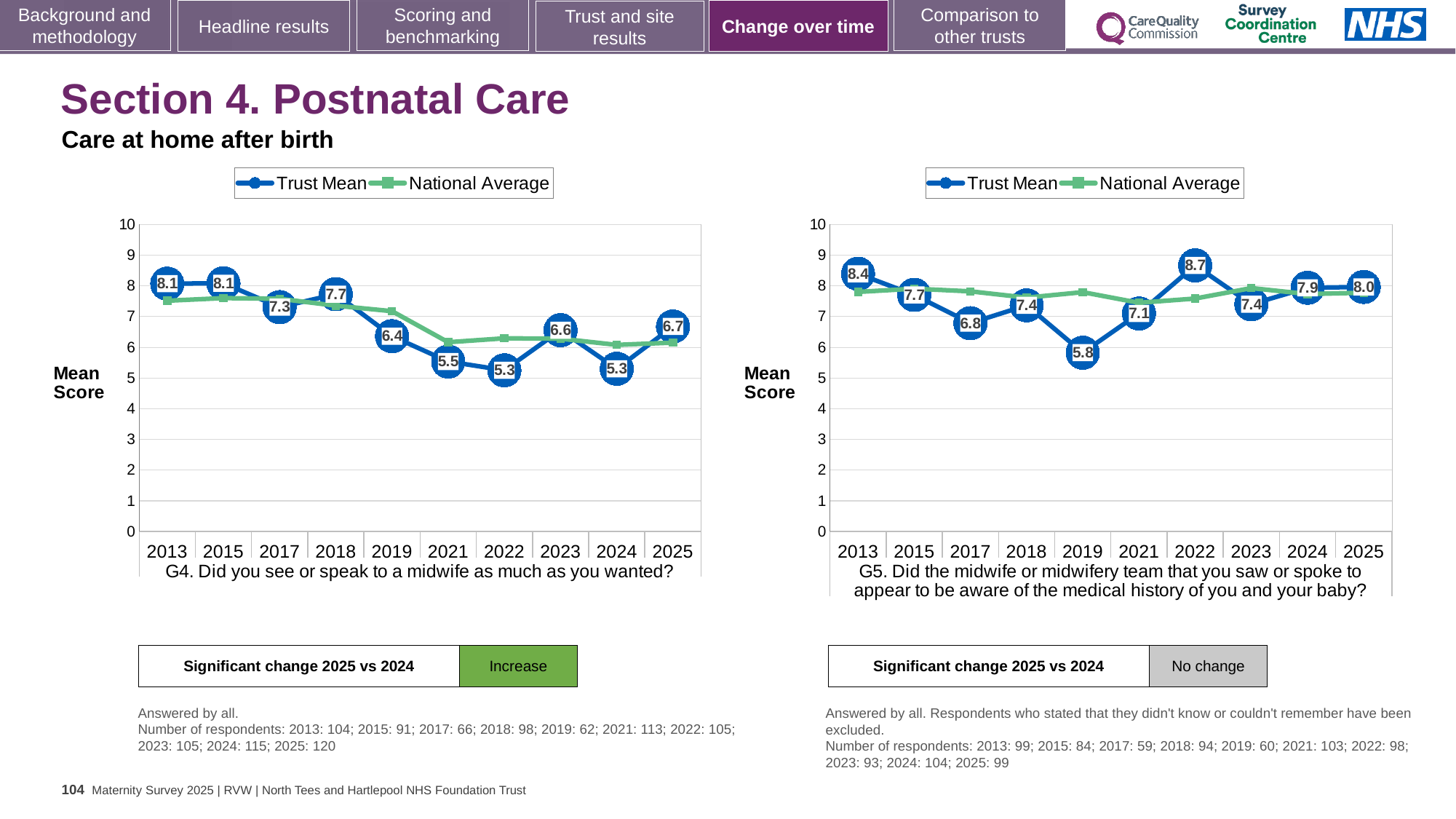
In the G4 chart (left), what is the difference between the Trust Mean scores for 2025 and 2024? 1.4 In the G5 chart (right), what is the Trust Mean score for 2022? 8.7 In the G5 chart (right), which year has the highest Trust Mean score? 2022 How many years are plotted on the x axis of the G5 chart (right)? 10 How many series does the legend of the G4 chart (left) list? 2 In the G4 chart (left), is the National Average value for 2022 greater or less than 7? less In the G4 chart (left), what is the Trust Mean score for 2025? 6.7 In the G5 chart (right), what is the difference between the Trust Mean scores for 2013 and 2019? 2.6 In the G4 chart (left), which is larger: the Trust Mean score for 2018 or for 2021? 2018 In the G4 chart (left), what is the Trust Mean score for 2019? 6.4 What kind of chart is the G5 chart (right)? Line chart In the G5 chart (right), which year has the lowest Trust Mean score? 2019